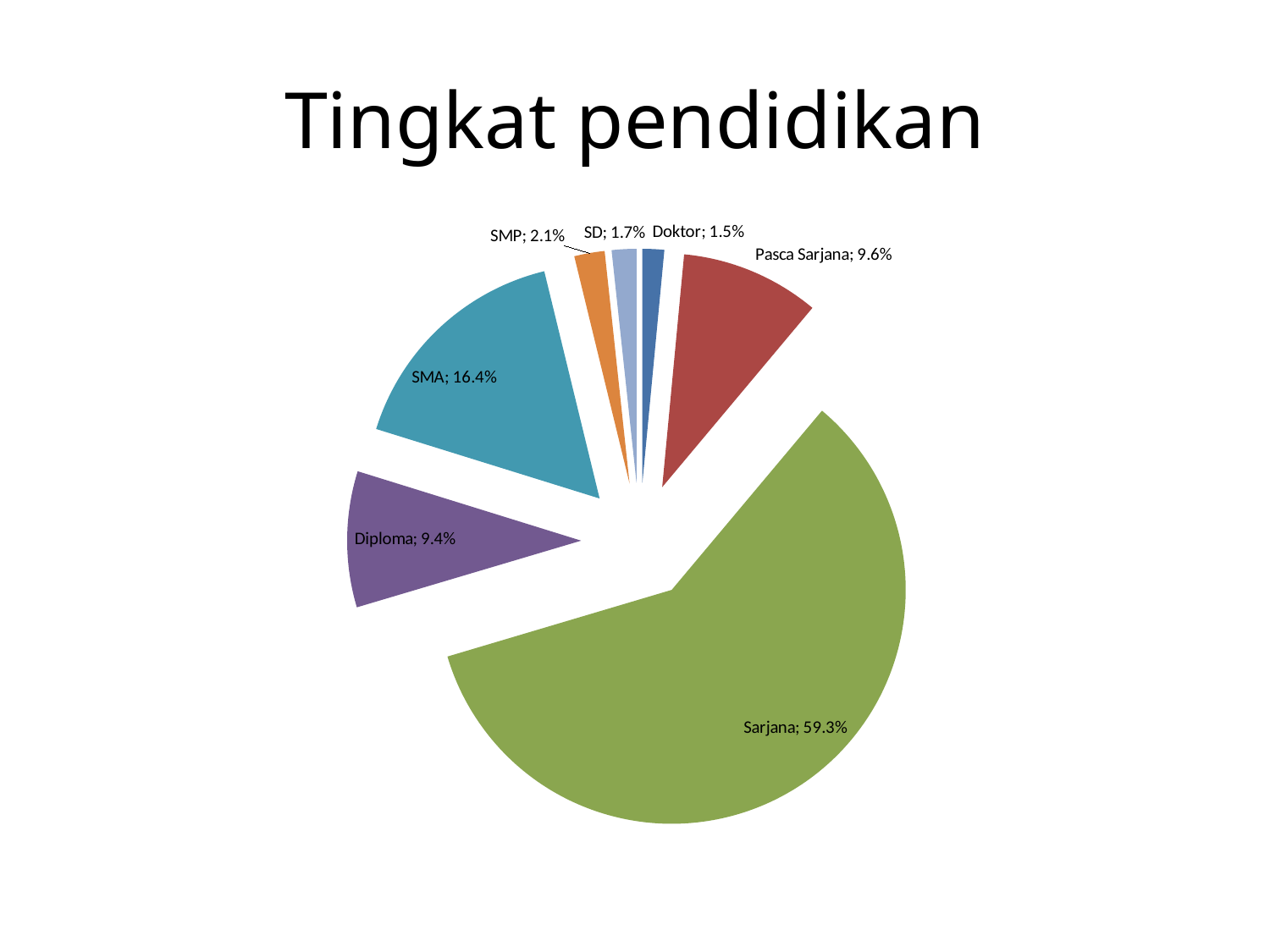
What is the difference between the shares of SMP and SD? 0.4% What is the share for Sarjana? 59.3% What type of chart is shown on the slide? Pie chart What is the difference between the shares of SMA and Diploma? 7.0% What is the title of the chart? Tingkat pendidikan What is the share for Doktor? 1.5% How many categories are shown in the pie chart? 7 What is the share for SMA? 16.4% What is the share for Pasca Sarjana? 9.6% Which category has the largest slice? Sarjana Which category has the smallest slice? Doktor Which is larger, the share for Pasca Sarjana or the share for Diploma? Pasca Sarjana